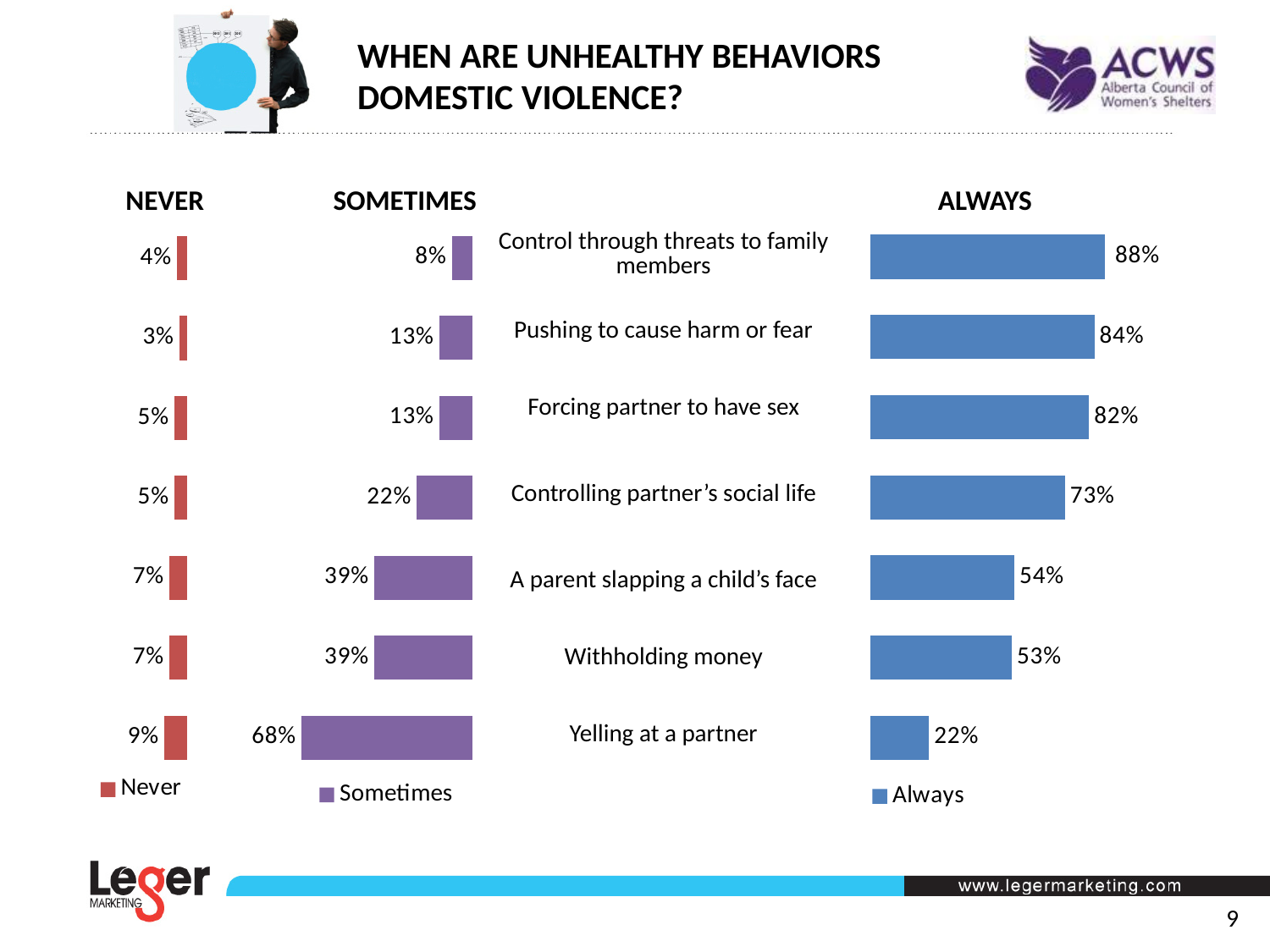
In the ALWAYS chart, what is the difference between 'Control through threats to family members' and 'Yelling at a partner'? 66% In the NEVER chart, what percentage is shown for 'Pushing to cause harm or fear'? 3% In the SOMETIMES chart, which is larger: 'Controlling partner's social life' or 'Forcing partner to have sex'? Controlling partner's social life In the ALWAYS chart, what percentage is shown for 'Control through threats to family members'? 88% In the ALWAYS chart, which behavior has the lowest percentage? Yelling at a partner What kind of chart is the SOMETIMES chart? Bar chart In the SOMETIMES chart, what percentage is shown for 'Yelling at a partner'? 68% How many behaviors are listed in the ALWAYS chart? 7 In the NEVER chart, which behavior has the highest percentage? Yelling at a partner In the SOMETIMES chart, what is the difference between 'A parent slapping a child's face' and 'Control through threats to family members'? 31% In the ALWAYS chart, do the values rise or fall going from the top behavior to the bottom behavior? Fall What colour are the bars in the ALWAYS chart? Blue